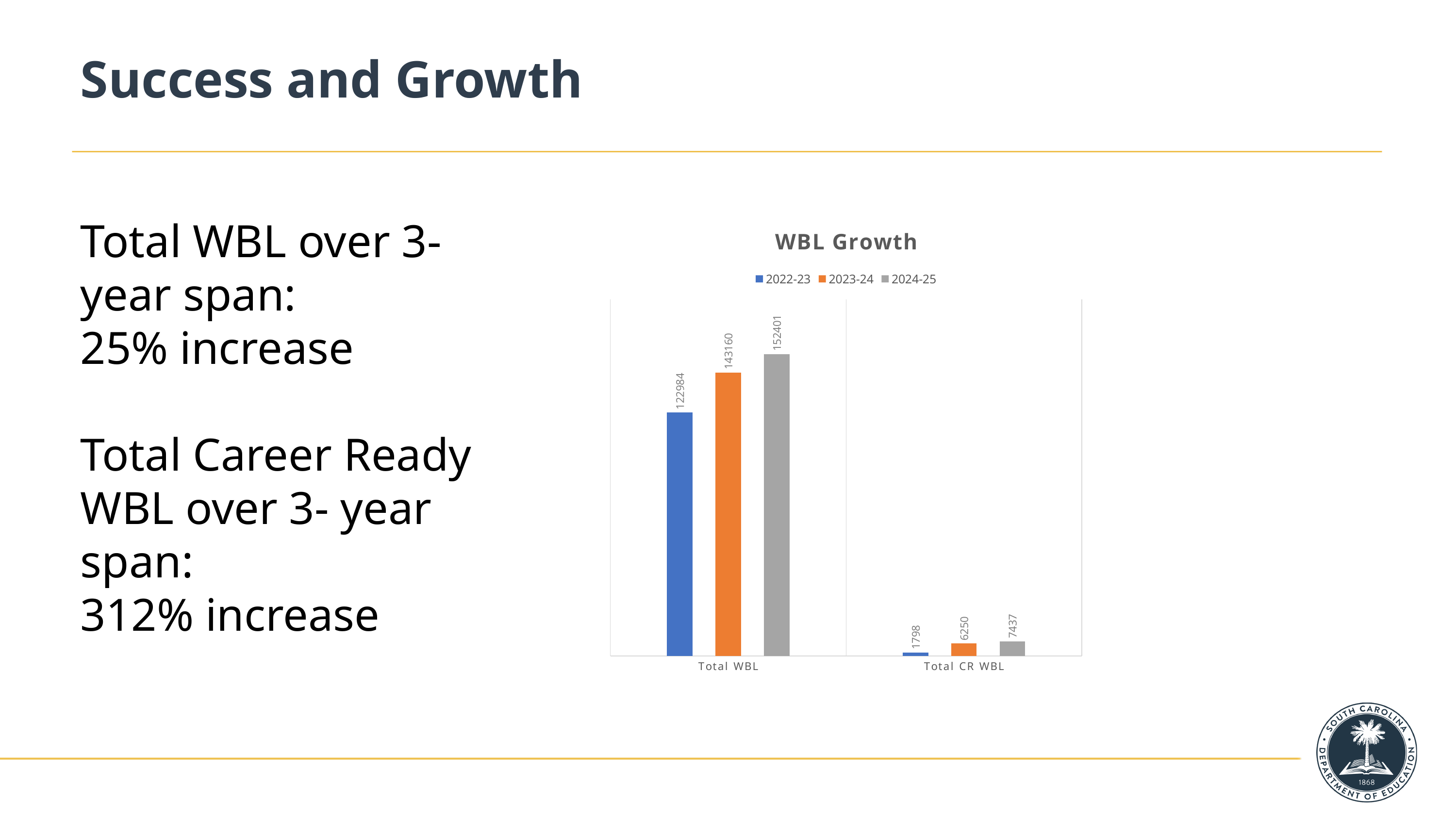
What is the difference between the Total WBL values for 2024-25 and 2022-23? 29417 Which year has the lowest value for Total WBL? 2022-23 What is the value for Total CR WBL in 2023-24? 6250 What is the value for Total WBL in 2024-25? 152401 What is the title of the chart? WBL Growth What is the value for Total WBL in 2022-23? 122984 What is the difference between the Total CR WBL values for 2023-24 and 2022-23? 4452 What is the value for Total CR WBL in 2022-23? 1798 Which is larger: Total WBL in 2023-24 or Total WBL in 2024-25? Total WBL in 2024-25 Which year has the highest value for Total CR WBL? 2024-25 How many series does the legend list? 3 What kind of chart is shown on the slide? Bar chart